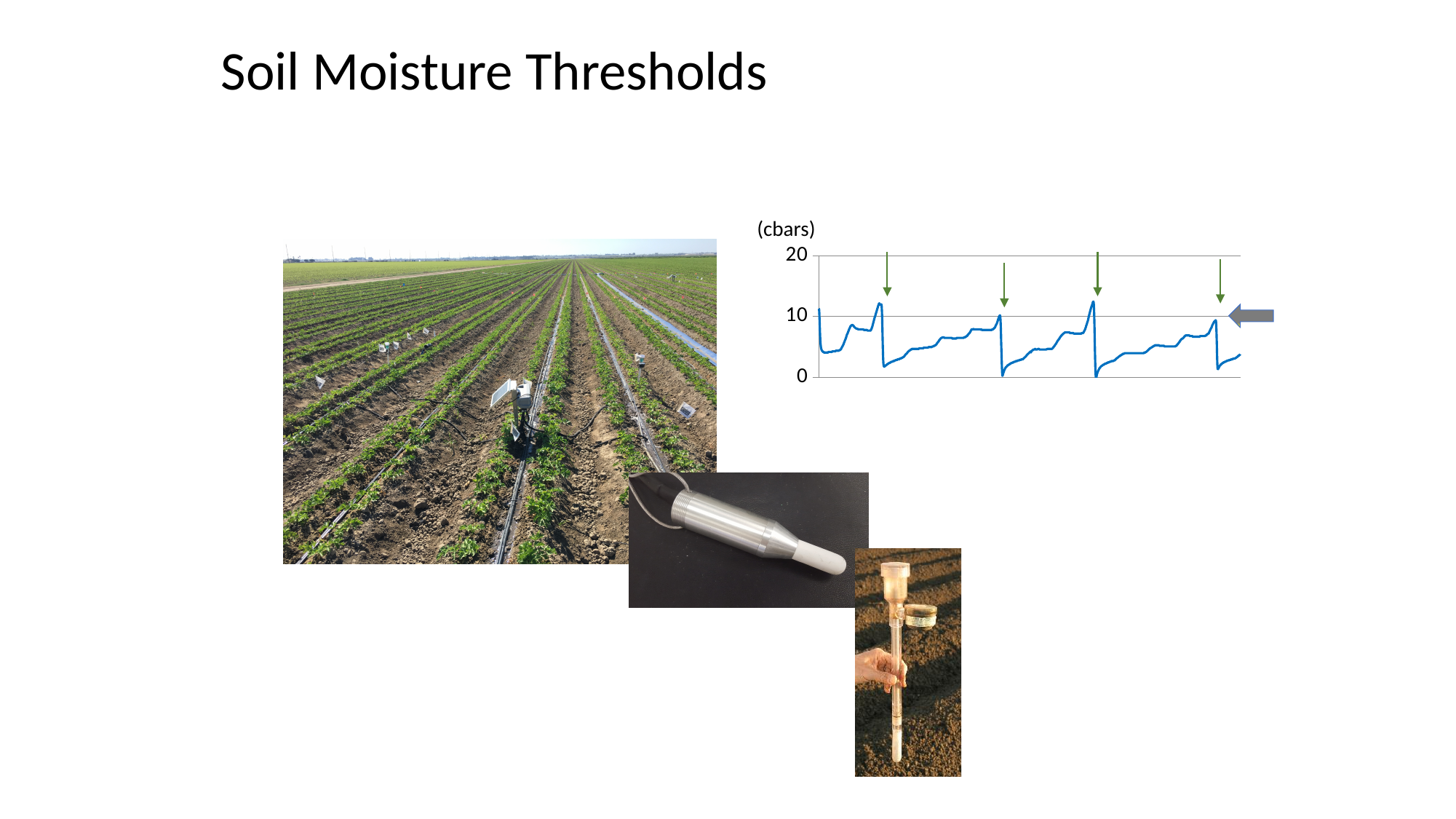
What unit is shown on the y axis of the chart? cbars Is the value of the line immediately after each sharp drop greater or less than 10? less Is the value at the first green-arrow peak greater or less than 20? less Between each sharp drop and the next peak, does the line rise or fall? rise Which y-axis gridline does the grey horizontal arrow on the right of the chart point to? 10 What is the highest value labelled on the y axis of the chart? 20 How many data series are plotted in the chart? 1 Is the value at the first green-arrow peak greater or less than 10? greater What kind of chart is shown on the slide? line chart How many green downward arrows mark peaks on the chart? 4